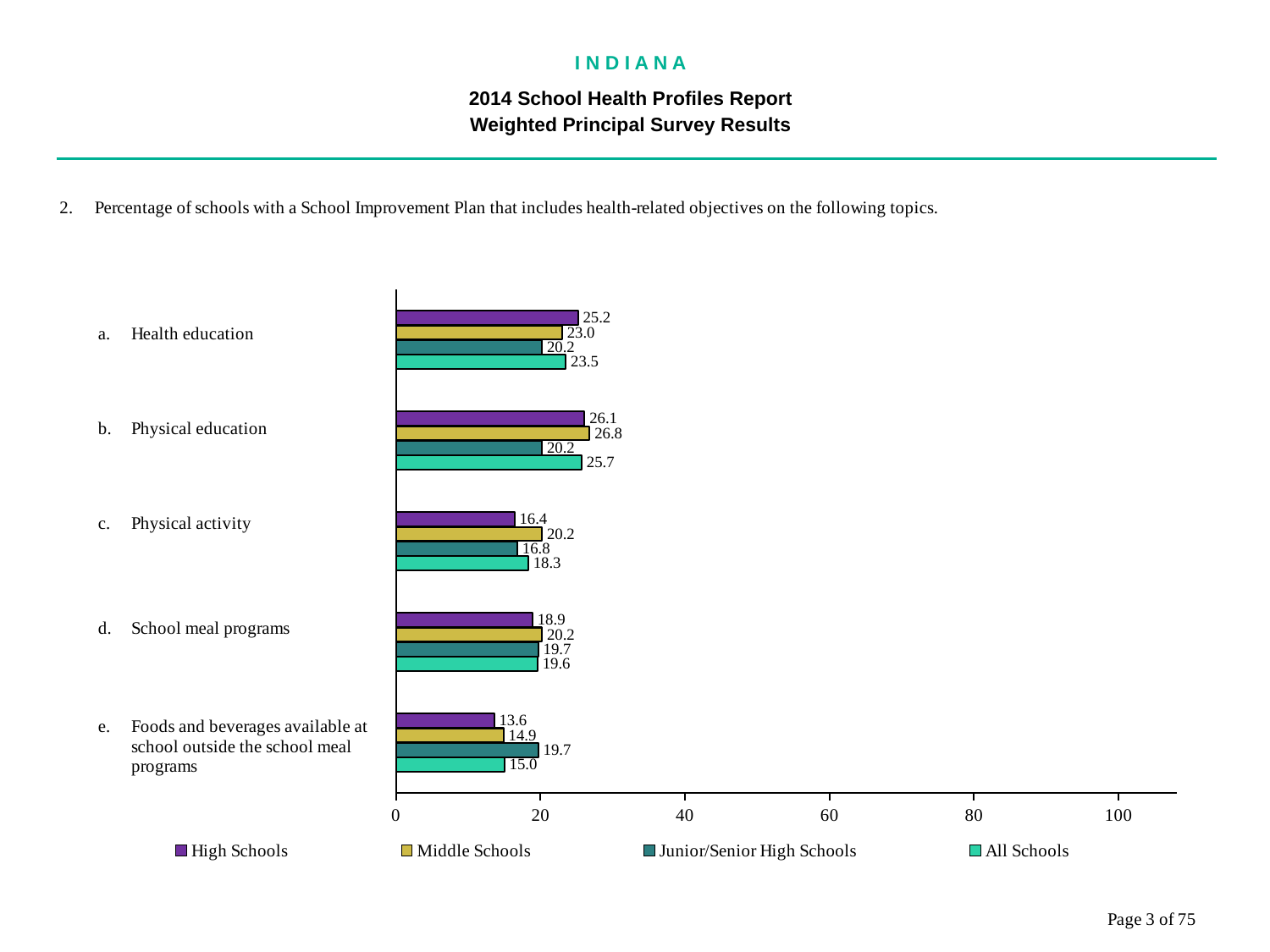
Which is larger for School meal programs: the High Schools value or the Middle Schools value? Middle Schools How many series does the legend list? 4 Which topic has the highest value for All Schools? Physical education What kind of chart is shown on the slide? Bar chart What is the value for Junior/Senior High Schools for Foods and beverages available at school outside the school meal programs? 19.7 Is the value for Middle Schools for Physical education greater or less than 20? greater How many topics (categories) are shown in the chart? 5 Which topic has the lowest value for High Schools? Foods and beverages available at school outside the school meal programs What is the value for High Schools for Health education? 25.2 What is the value for Middle Schools for Physical education? 26.8 What is the value for All Schools for Physical activity? 18.3 What is the difference between the High Schools and Middle Schools values for Health education? 2.2